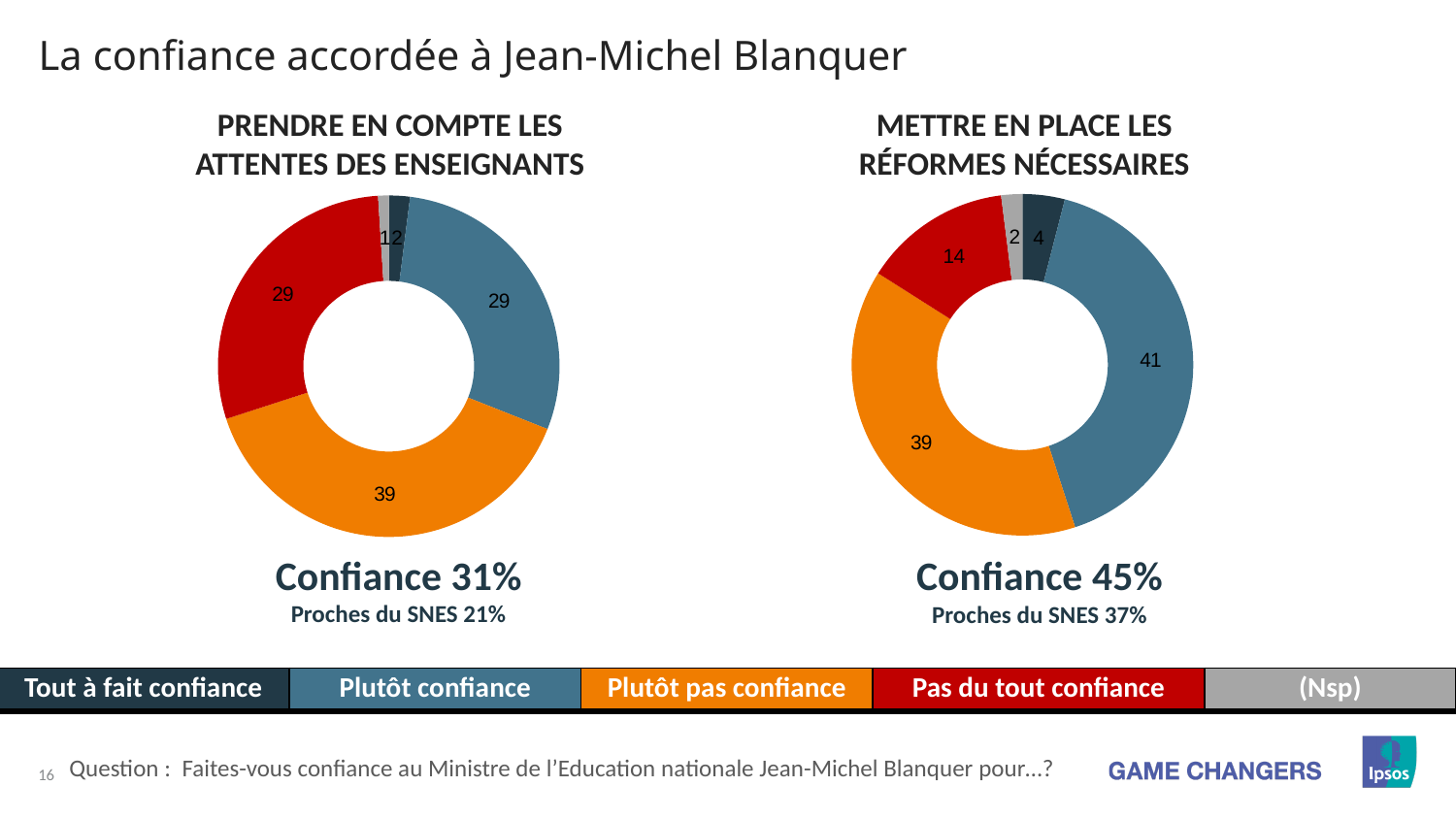
In the chart 'PRENDRE EN COMPTE LES ATTENTES DES ENSEIGNANTS', what is the value for 'Pas du tout confiance'? 29 What overall 'Confiance' percentage is shown under the chart 'METTRE EN PLACE LES RÉFORMES NÉCESSAIRES'? 45% In the chart 'PRENDRE EN COMPTE LES ATTENTES DES ENSEIGNANTS', which category has the largest slice? Plutôt pas confiance In the chart 'METTRE EN PLACE LES RÉFORMES NÉCESSAIRES', what is the difference between 'Plutôt confiance' and 'Pas du tout confiance'? 27 In the chart 'METTRE EN PLACE LES RÉFORMES NÉCESSAIRES', what is the value for 'Plutôt confiance'? 41 In the chart 'METTRE EN PLACE LES RÉFORMES NÉCESSAIRES', which category has the largest slice? Plutôt confiance What kind of chart is used on this slide? Pie chart (donut) How many categories does the legend at the bottom of the slide list? 5 In the chart 'METTRE EN PLACE LES RÉFORMES NÉCESSAIRES', what is the value for 'Tout à fait confiance'? 4 Which chart shows a larger value for 'Pas du tout confiance', the left one or the right one? The left one (PRENDRE EN COMPTE LES ATTENTES DES ENSEIGNANTS) In the chart 'METTRE EN PLACE LES RÉFORMES NÉCESSAIRES', what is the value for 'Pas du tout confiance'? 14 In the chart 'PRENDRE EN COMPTE LES ATTENTES DES ENSEIGNANTS', what is the value for 'Plutôt pas confiance'? 39